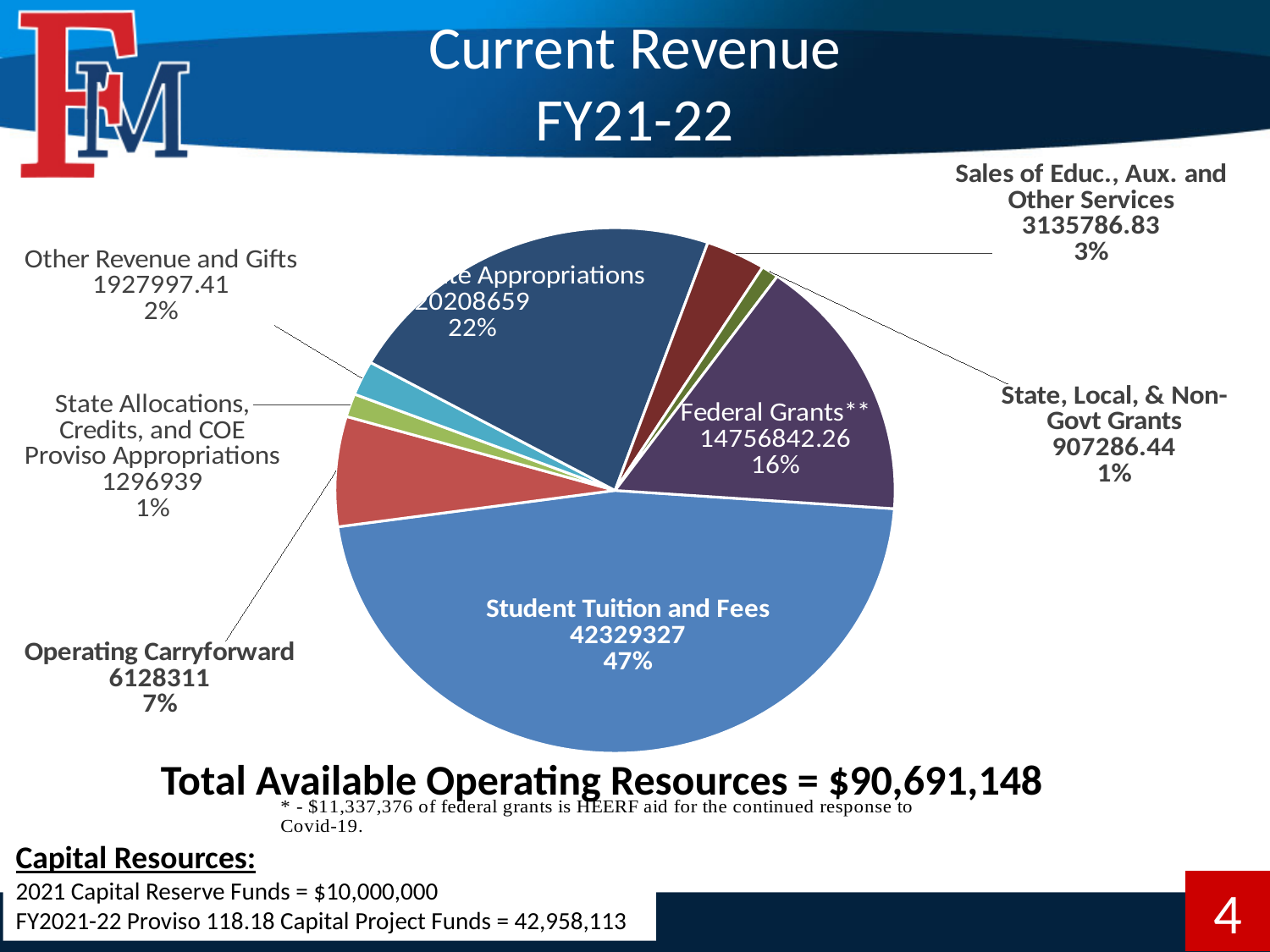
What share of the pie does Student Tuition and Fees represent? 47% What share of the pie does Federal Grants represent? 16% What is the value for Student Tuition and Fees? 42329327 What is the difference between Operating Carryforward and Sales of Educ., Aux. and Other Services? 2992524.17 How many slices does the pie chart have? 8 Which category has the largest slice of the pie? Student Tuition and Fees Which category has the smallest value in the pie? State, Local, & Non-Govt Grants Which is larger: Sales of Educ., Aux. and Other Services or Other Revenue and Gifts? Sales of Educ., Aux. and Other Services What is the title of the slide containing the pie chart? Current Revenue FY21-22 What is the value for Operating Carryforward? 6128311 What kind of chart is shown on the slide? pie chart What is the value for Federal Grants? 14756842.26